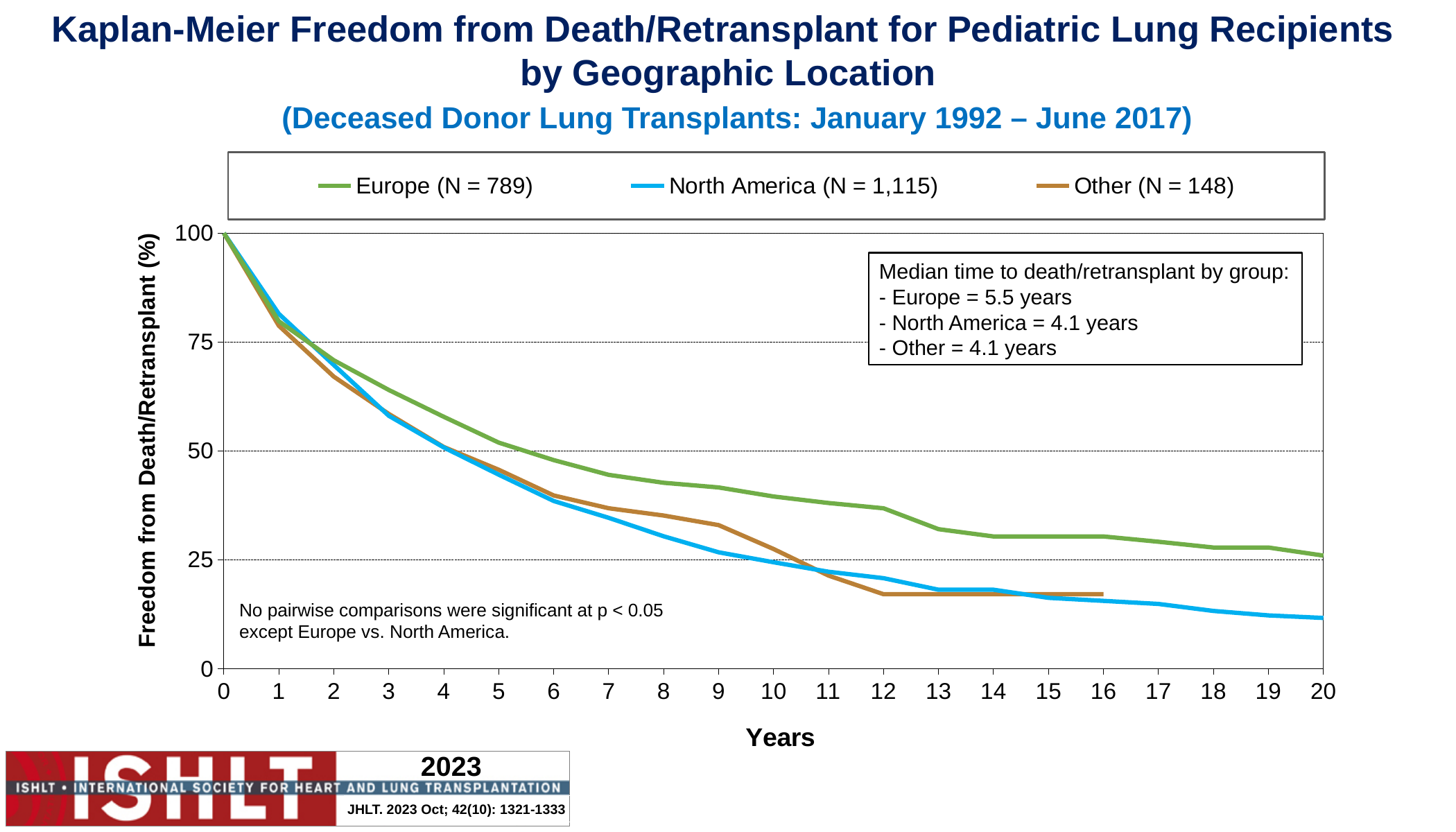
What is the median time to death/retransplant for North America according to the text box? 4.1 years Do the values for the Europe series rise or fall as years increase along the x axis? fall At year 8, which is larger: the value for Europe or the value for North America? Europe What is the sample size (N) for the Other series in the legend? 148 Which series has the highest freedom from death/retransplant at year 10? Europe (N = 789) What is the freedom from death/retransplant value for all three groups at year 0? 100 What is the median time to death/retransplant for Europe according to the text box? 5.5 years What kind of chart is shown on the slide? line chart Is the value for Europe at year 10 greater or less than 50? less Is the value for North America at year 20 greater or less than 25? less How many series does the legend list? 3 What is the sample size (N) for the North America series in the legend? 1,115